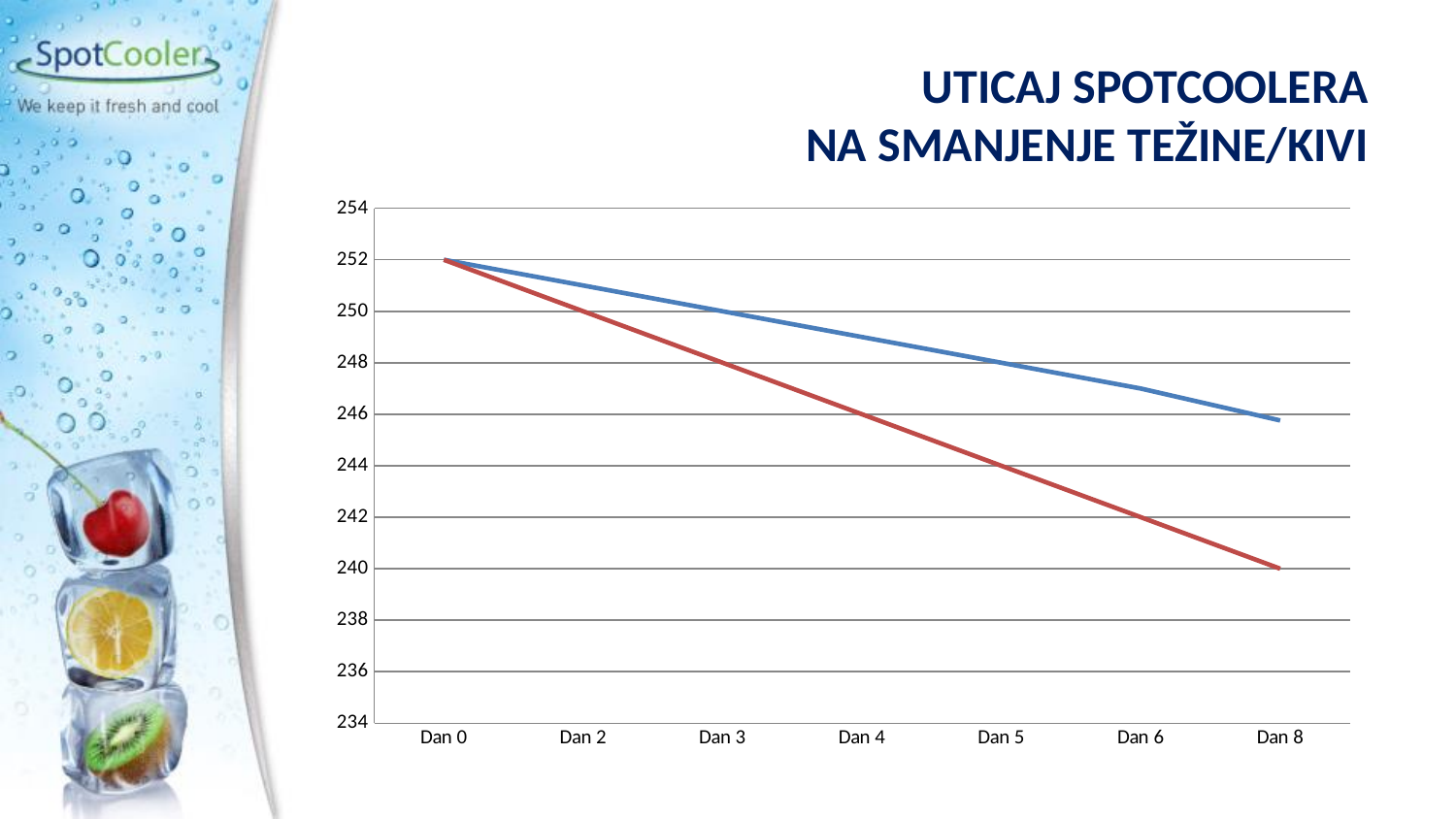
How many categories are shown on the x axis of the chart? 7 Is the value of the red line at Dan 6 greater or less than 244? less Is the value of the blue line at Dan 8 greater or less than 244? greater Which category has the lowest value for the red line? Dan 8 What is the value of the blue line at Dan 0? 252 What is the value of the red line at Dan 8? 240 At Dan 5, which line has the higher value, the blue line or the red line? Blue line Do the values of the red line rise or fall from Dan 0 to Dan 8? Fall Do the values of the blue line rise or fall from Dan 0 to Dan 8? Fall What kind of chart is shown on the slide? Line chart What is the title of the chart on the slide? UTICAJ SPOTCOOLERA NA SMANJENJE TEŽINE/KIVI How many lines are plotted on the chart? 2